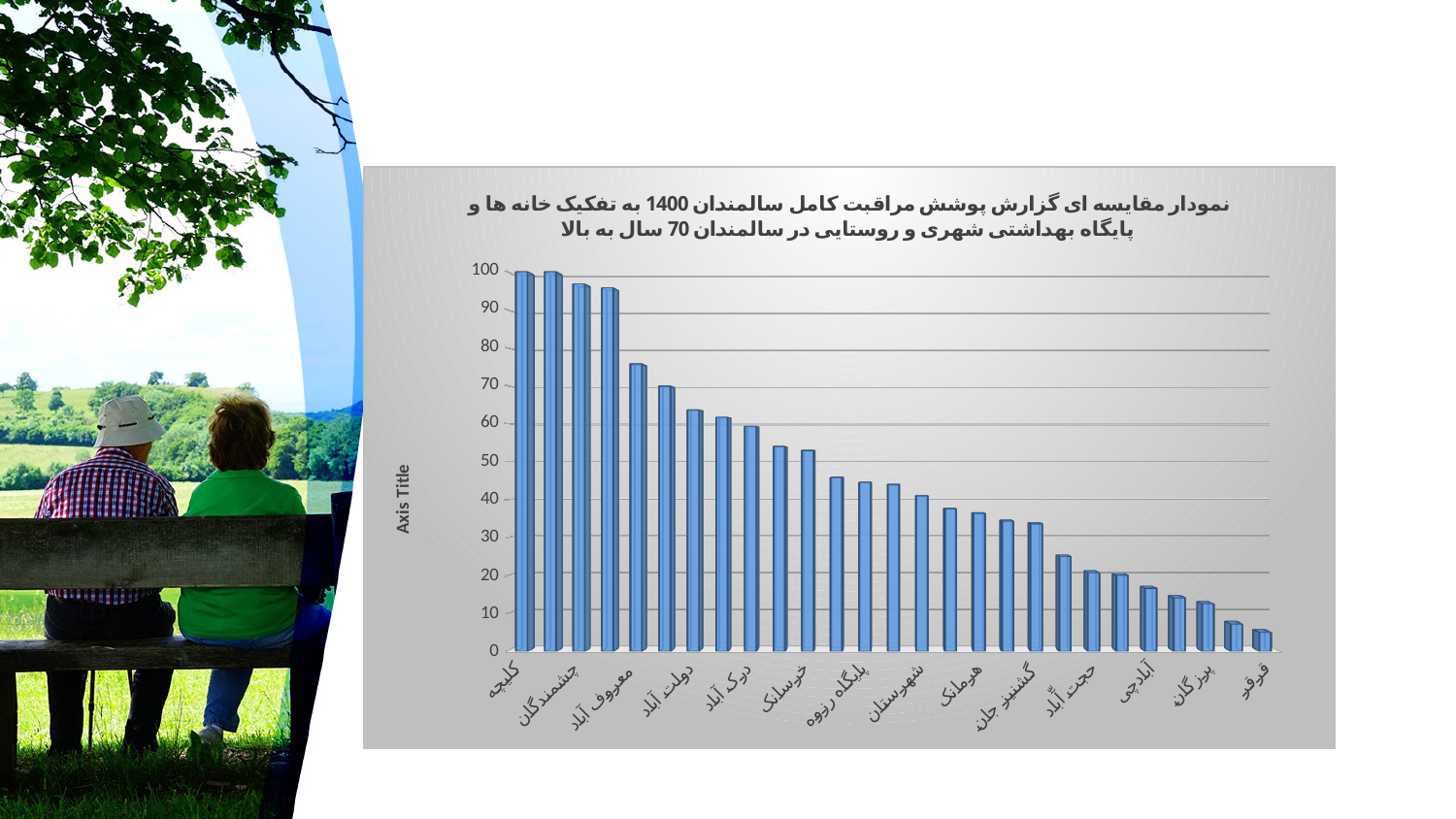
Which category has the lowest value in the chart? قرقر Is the value for کلیچه greater or less than 90? greater What is the label shown on the vertical axis of the chart? Axis Title Which is larger, the value for چشمندگان or the value for دولت آباد? چشمندگان Do the values rise or fall moving from left to right along the x axis? fall What kind of chart is shown on the slide? bar chart Is the value for شهرستان greater or less than 50? less Is the value for حجت آباد greater or less than 30? less Which category has the highest value in the chart? کلیچه